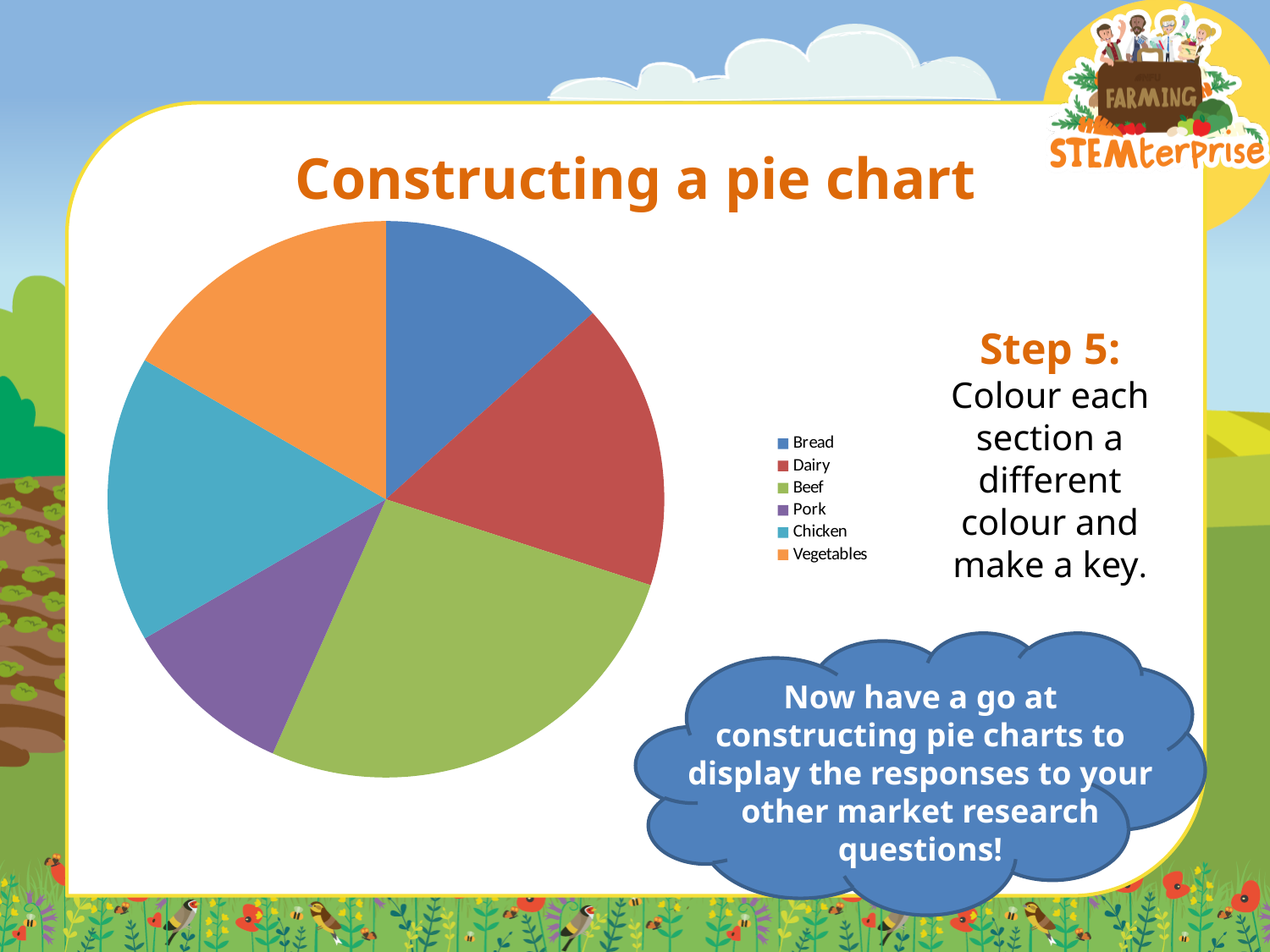
Which slice is larger, Chicken or Pork? Chicken Which slice is larger, Beef or Pork? Beef How many entries does the legend of the pie chart list? 6 Which category has the largest slice of the pie chart? Beef What kind of chart is shown on the slide? Pie chart What colour is the Beef slice in the pie chart? Green What is the title of the slide containing the pie chart? Constructing a pie chart Which slice is larger, Beef or Dairy? Beef Which category has the smallest slice of the pie chart? Pork How many categories (slices) does the pie chart have? 6